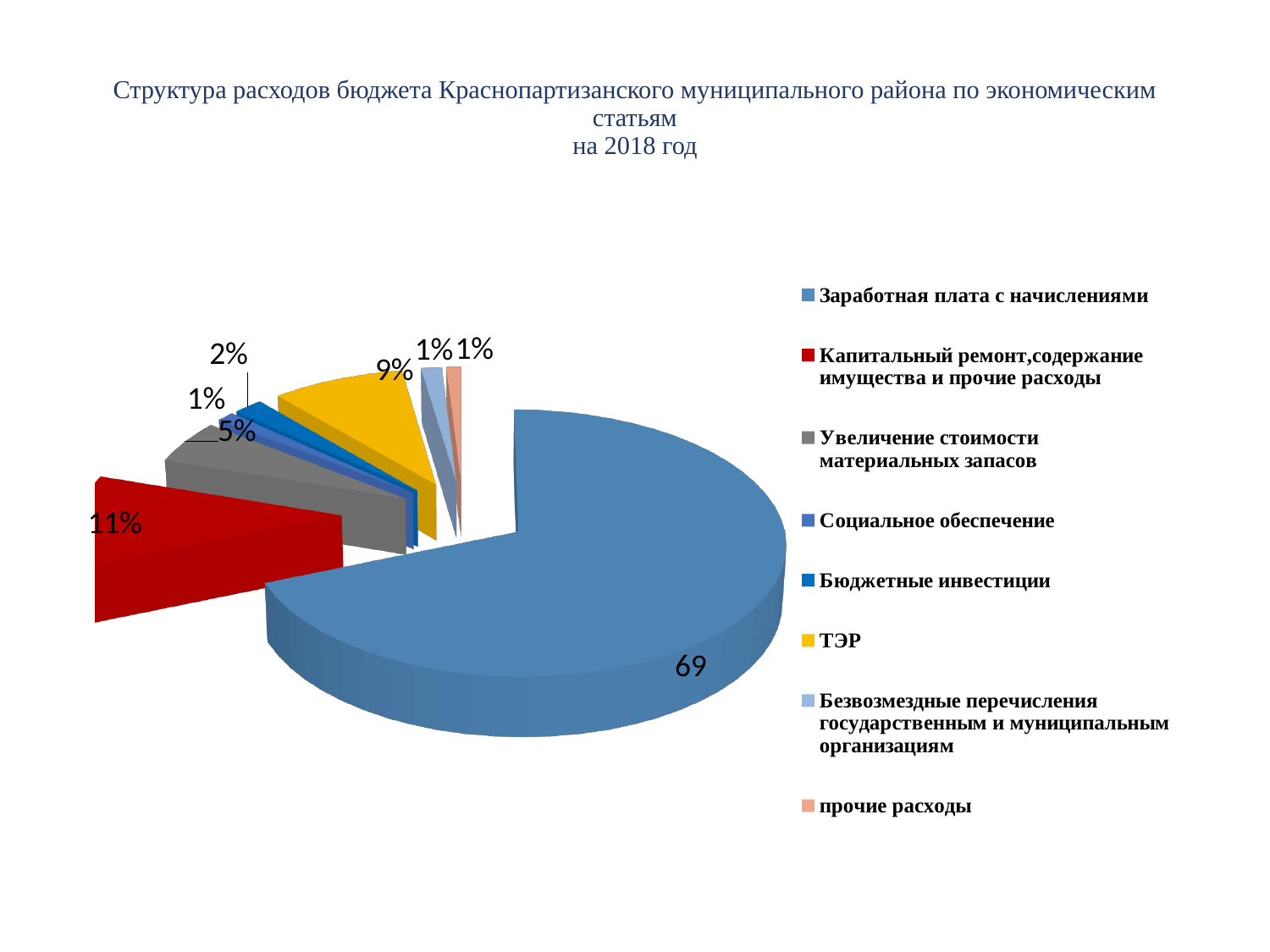
Which is larger: the share for 'Капитальный ремонт,содержание имущества и прочие расходы' or the share for 'ТЭР'? Капитальный ремонт,содержание имущества и прочие расходы What share is shown for 'Увеличение стоимости материальных запасов'? 5% What share is shown for 'Капитальный ремонт,содержание имущества и прочие расходы'? 11% What kind of chart is shown on the slide? pie chart Which category has the largest slice of the pie? Заработная плата с начислениями How many categories does the legend list? 8 What value is shown for the slice 'Заработная плата с начислениями'? 69 What share is shown for 'ТЭР'? 9% What is the difference in percentage points between 'Капитальный ремонт,содержание имущества и прочие расходы' (11%) and 'Увеличение стоимости материальных запасов' (5%)? 6 What share is shown for 'прочие расходы'? 1% Which year does the chart title say the budget expenditure structure refers to? 2018 What share is shown for 'Бюджетные инвестиции'? 2%